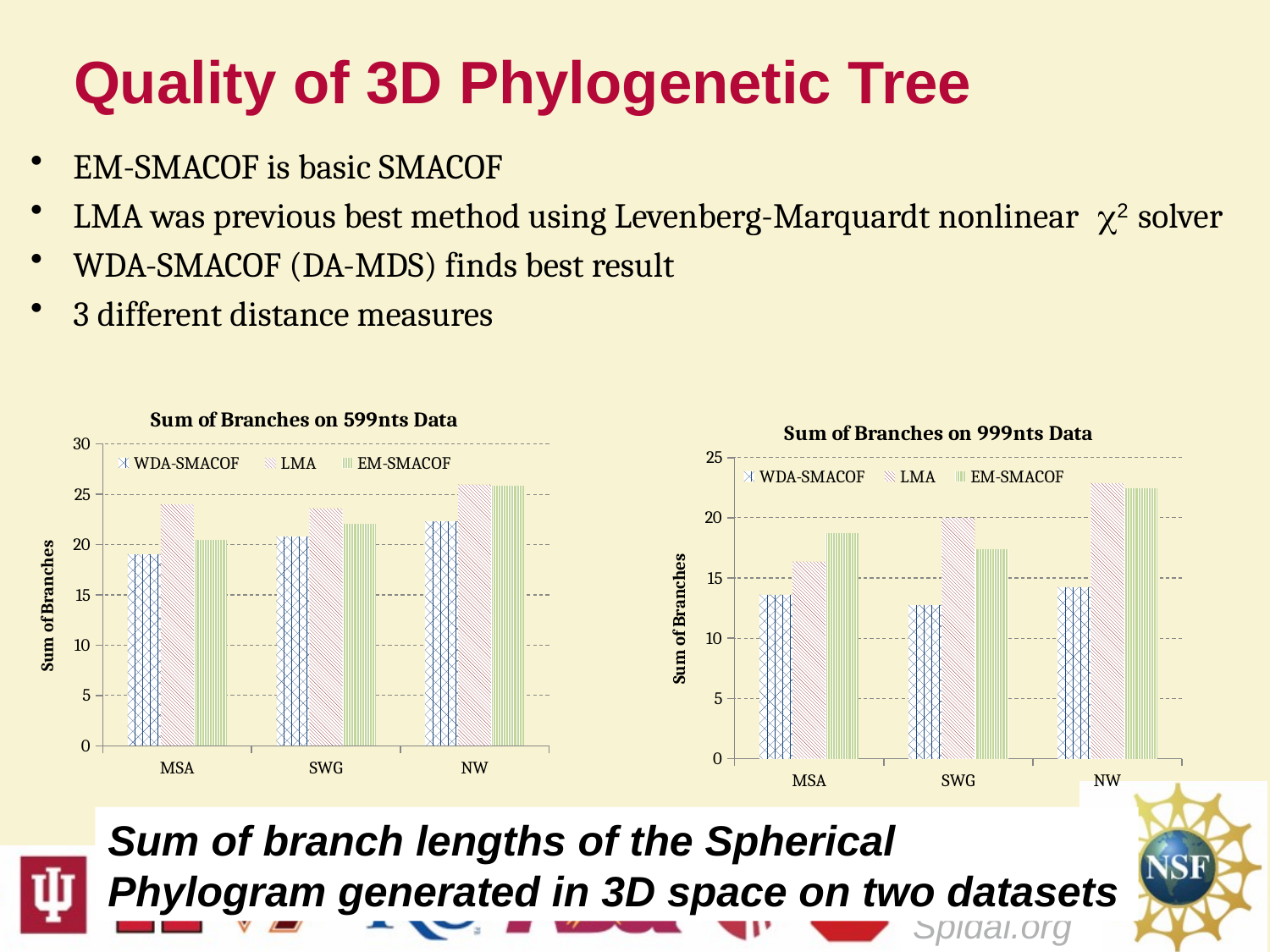
What is the title of the chart on the right side of the slide? Sum of Branches on 999nts Data In the chart titled "Sum of Branches on 599nts Data", is the LMA value for MSA greater or less than 20? greater In the chart titled "Sum of Branches on 599nts Data", what kind of chart is shown? bar chart In the chart titled "Sum of Branches on 999nts Data", is the WDA-SMACOF value for SWG greater or less than 15? less In the chart titled "Sum of Branches on 999nts Data", how many categories are shown on the x axis? 3 In the chart titled "Sum of Branches on 599nts Data", do the WDA-SMACOF values rise or fall from MSA to SWG to NW? rise In the chart titled "Sum of Branches on 599nts Data", how many series does the legend list? 3 In the chart titled "Sum of Branches on 599nts Data", is the WDA-SMACOF value for NW greater or less than 25? less In the chart titled "Sum of Branches on 999nts Data", which category has the highest LMA value? NW In the chart titled "Sum of Branches on 599nts Data", for MSA, which is larger: LMA or EM-SMACOF? LMA In the chart titled "Sum of Branches on 999nts Data", for MSA, which is larger: EM-SMACOF or LMA? EM-SMACOF In the chart titled "Sum of Branches on 599nts Data", which category has the lowest WDA-SMACOF value? MSA